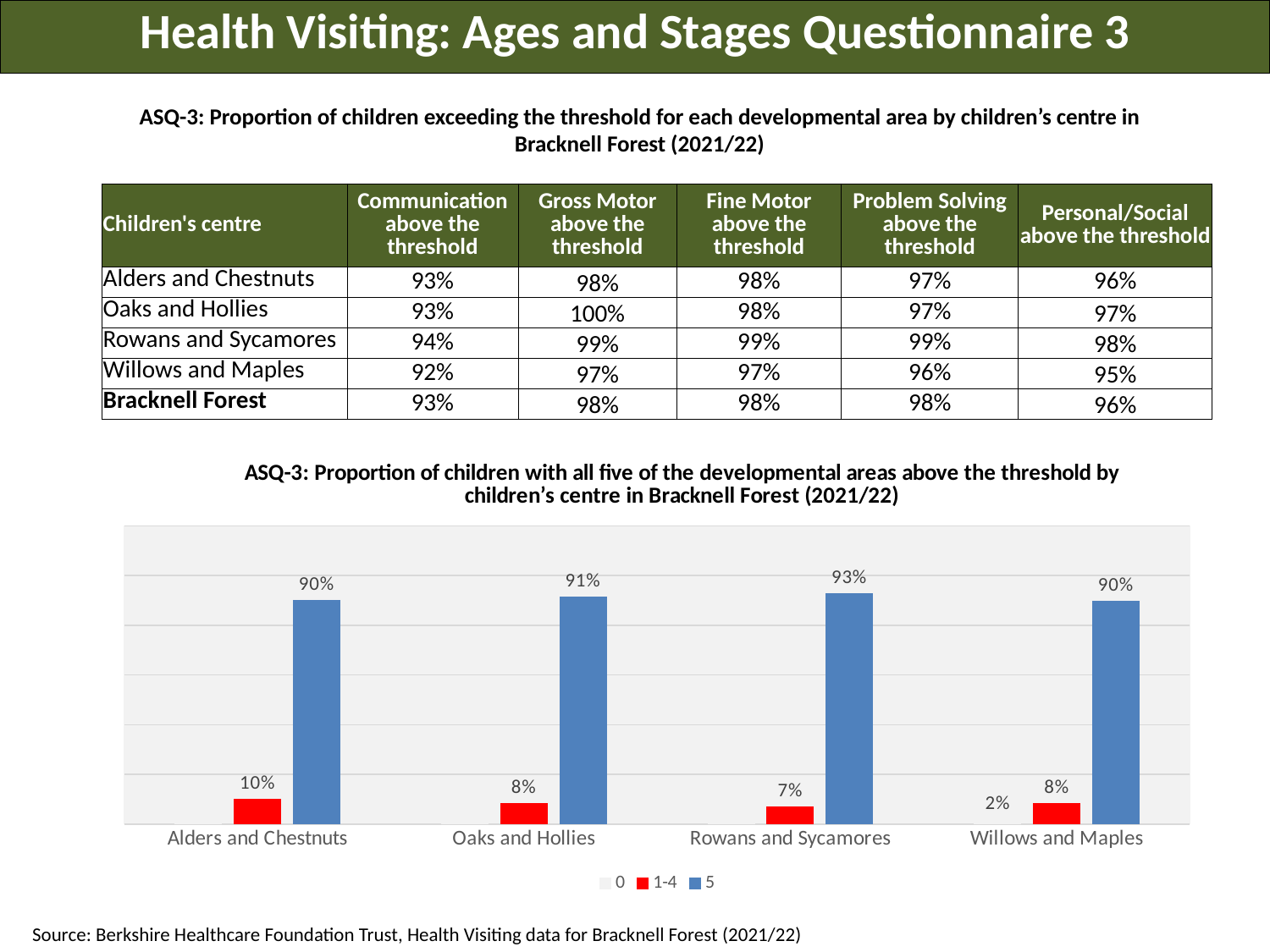
What is the value of the '0' series for Willows and Maples? 2% How many series does the chart legend list? 3 What kind of chart is shown on the slide? bar chart Which children's centre has the lowest value for the '1-4' series? Rowans and Sycamores What is the value of the '5' series for Oaks and Hollies? 91% What is the value of the '5' series for Rowans and Sycamores? 93% What colour are the bars for the '5' series in the chart? blue What is the value of the '1-4' series for Alders and Chestnuts? 10% How many children's centres are shown on the x axis of the chart? 4 What is the difference between the '5' series values for Rowans and Sycamores and Alders and Chestnuts? 3% Which is larger: the '1-4' value for Alders and Chestnuts or the '1-4' value for Oaks and Hollies? Alders and Chestnuts Which children's centre has the highest value for the '5' series? Rowans and Sycamores